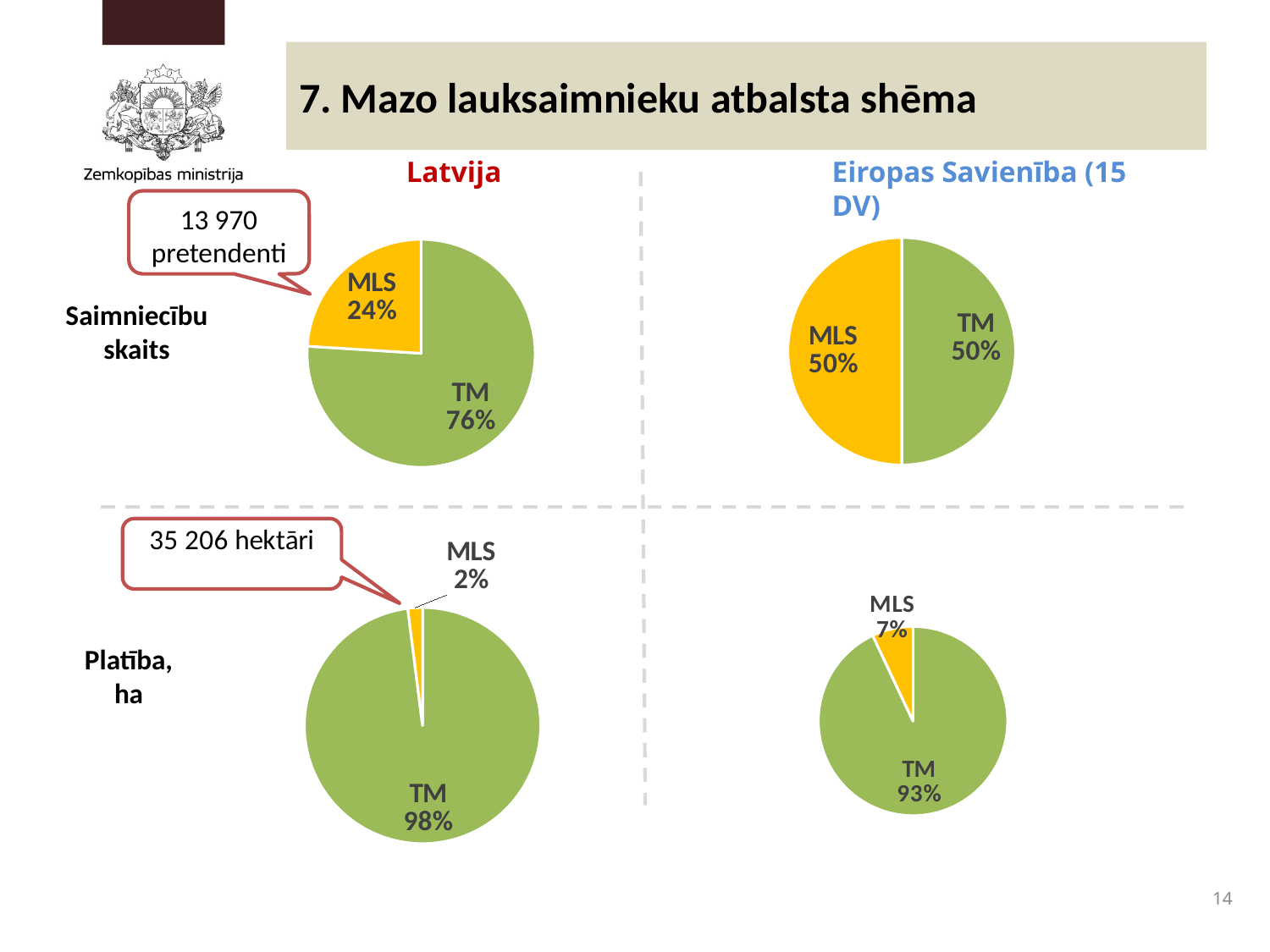
In the top-left pie chart (Latvija, Saimniecību skaits), what share is labelled for TM? 76% In the top-left pie chart (Latvija, Saimniecību skaits), what share is labelled for MLS? 24% In the bottom-right pie chart (Eiropas Savienība, Platība, ha), what share is labelled for TM? 93% In the top-left pie chart (Latvija, Saimniecību skaits), which slice is larger, MLS or TM? TM How many slices does the bottom-right pie chart (Eiropas Savienība, Platība, ha) have? 2 In the bottom-left pie chart (Latvija, Platība, ha), what is the difference in percentage points between the TM and MLS shares? 96 How many pie charts are shown on the slide? 4 What type of chart is used for the Latvija Saimniecību skaits data in the top-left? Pie chart